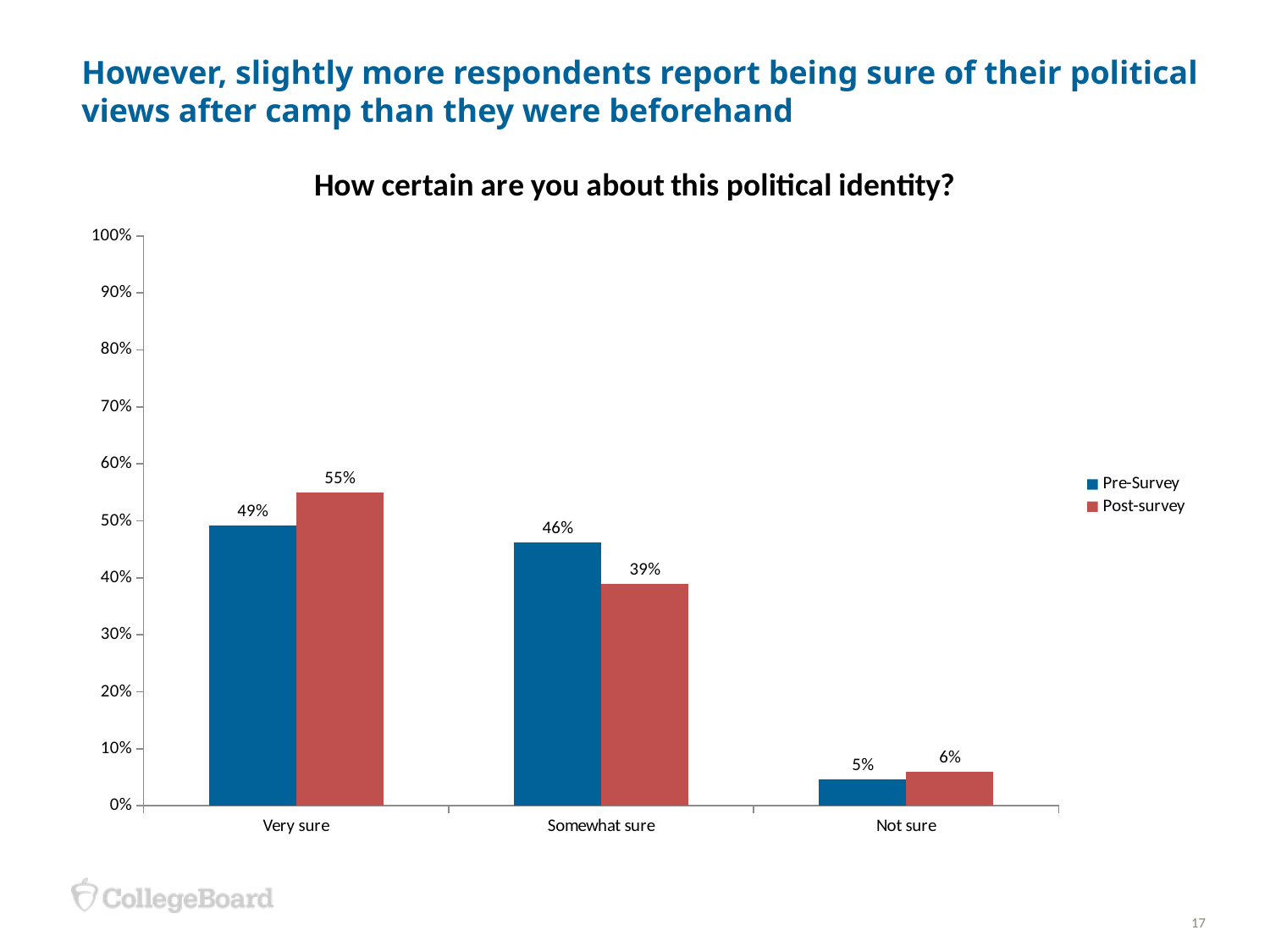
What is the difference between the Post-survey and Pre-Survey values for Very sure? 6% Which is larger for Somewhat sure, the Pre-Survey value or the Post-survey value? Pre-Survey Which category has the lowest Pre-Survey value? Not sure What is the Post-survey value for Not sure? 6% How many series does the legend list? 2 Is the Post-survey value for Very sure greater or less than 50%? greater What is the Pre-Survey value for Very sure? 49% How many categories are shown on the x axis? 3 Which category has the highest Post-survey value? Very sure What is the difference between the Pre-Survey and Post-survey values for Somewhat sure? 7% What kind of chart is shown on the slide? bar chart What is the Post-survey value for Somewhat sure? 39%